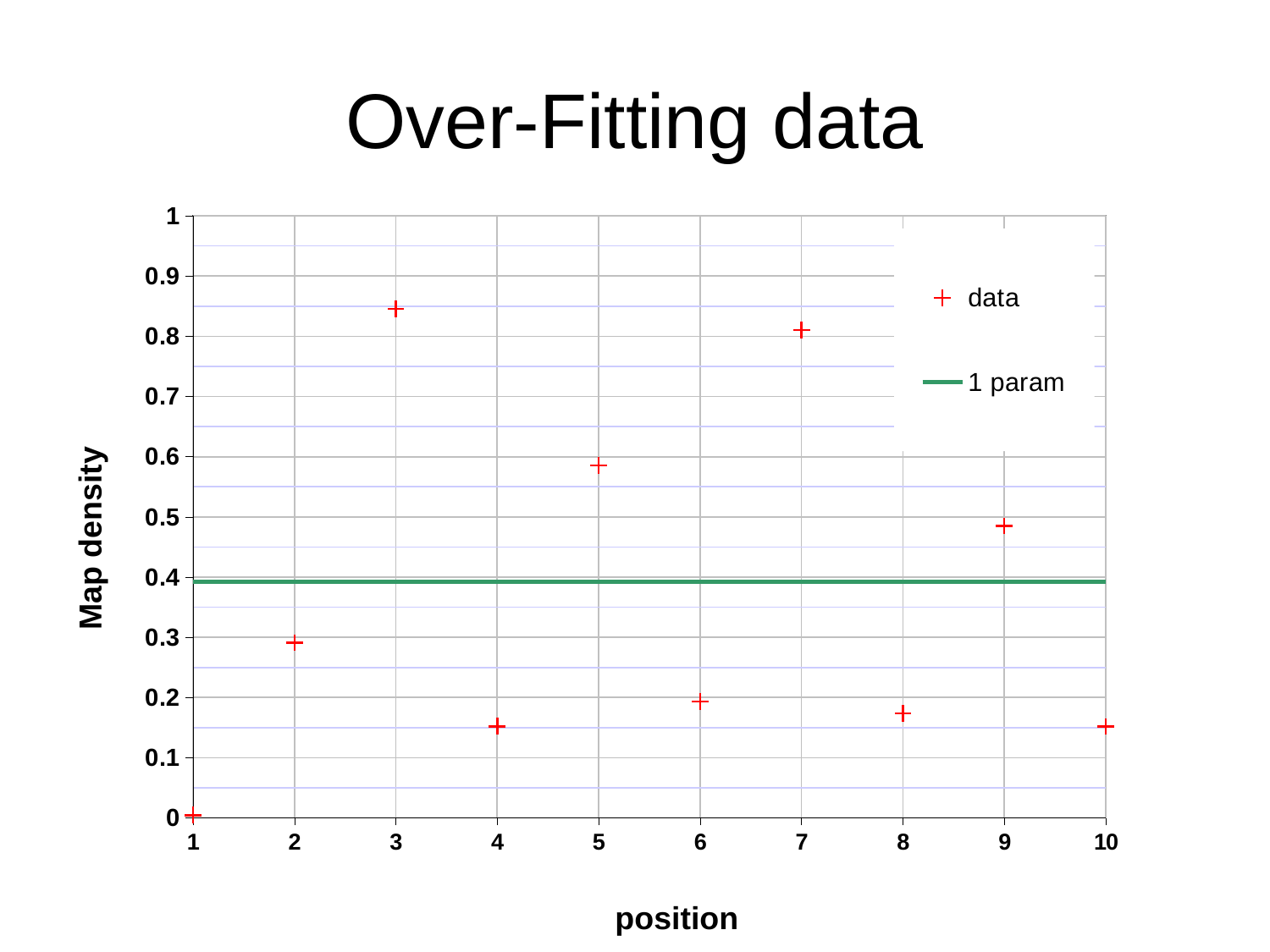
What is the label of the x axis? position What kind of chart is shown on the slide? scatter chart How many data points are plotted for the 'data' series? 10 What is the title of the chart? Over-Fitting data Is the Map density of the 'data' series at position 4 greater or less than 0.2? less At which position is the Map density of the 'data' series highest? 3 Is the Map density of the 'data' series at position 3 greater or less than 0.8? greater Which has the larger Map density in the 'data' series: position 5 or position 9? position 5 At which position is the Map density of the 'data' series lowest? 1 How many series does the legend list? 2 Is the Map density of the 'data' series at position 5 greater or less than 0.5? greater